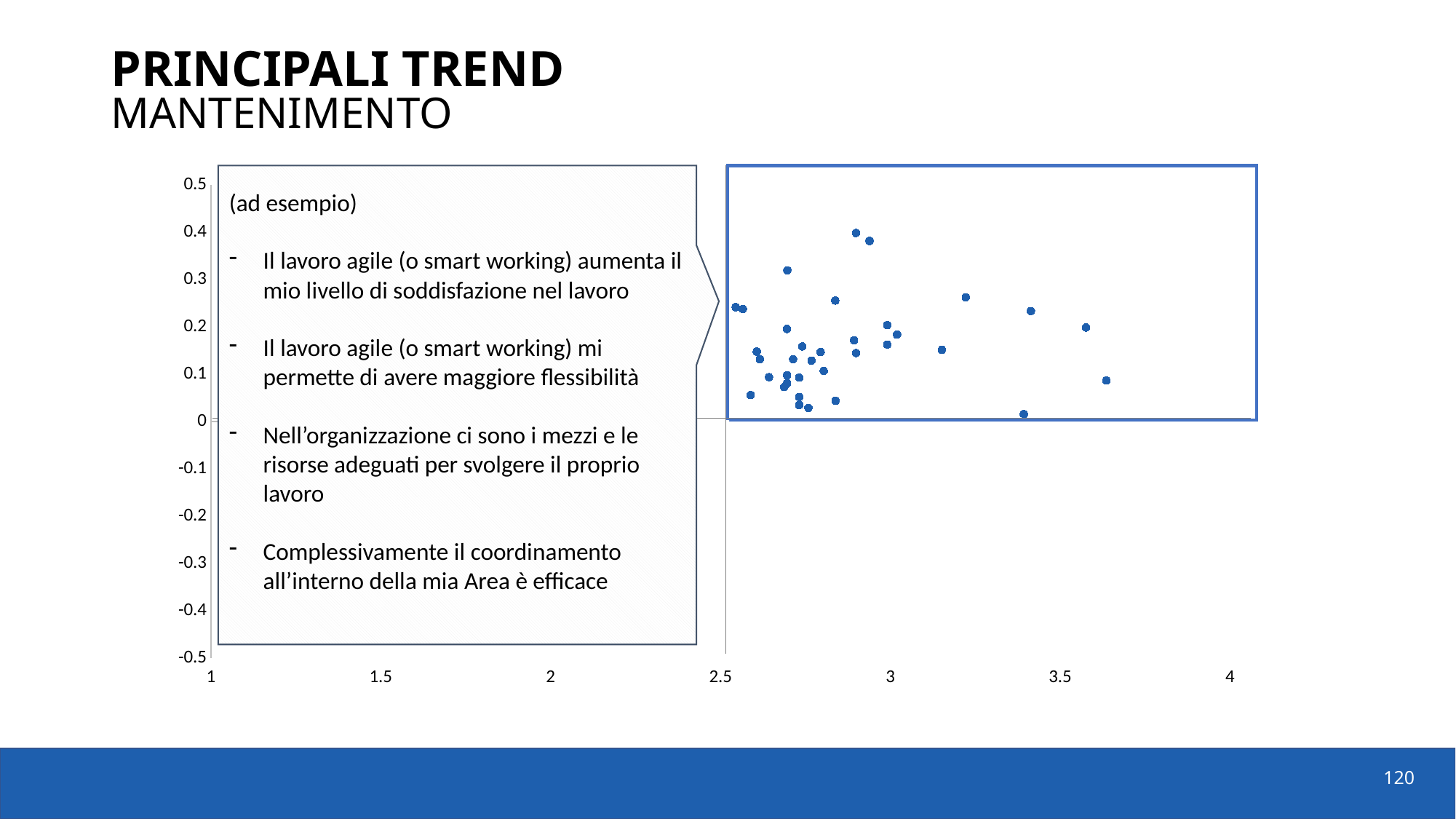
What is the largest tick value shown on the horizontal axis of the chart? 4 Is the highest plotted point in the chart greater or less than 0.5 on the vertical axis? less What kind of chart is shown on the slide? scatter chart Are the plotted points in the chart to the left or to the right of 2.5 on the horizontal axis? right What is the lowest value shown on the vertical axis of the chart? -0.5 Are the plotted points in the chart above or below 0 on the vertical axis? above What is the highest value shown on the vertical axis of the chart? 0.5